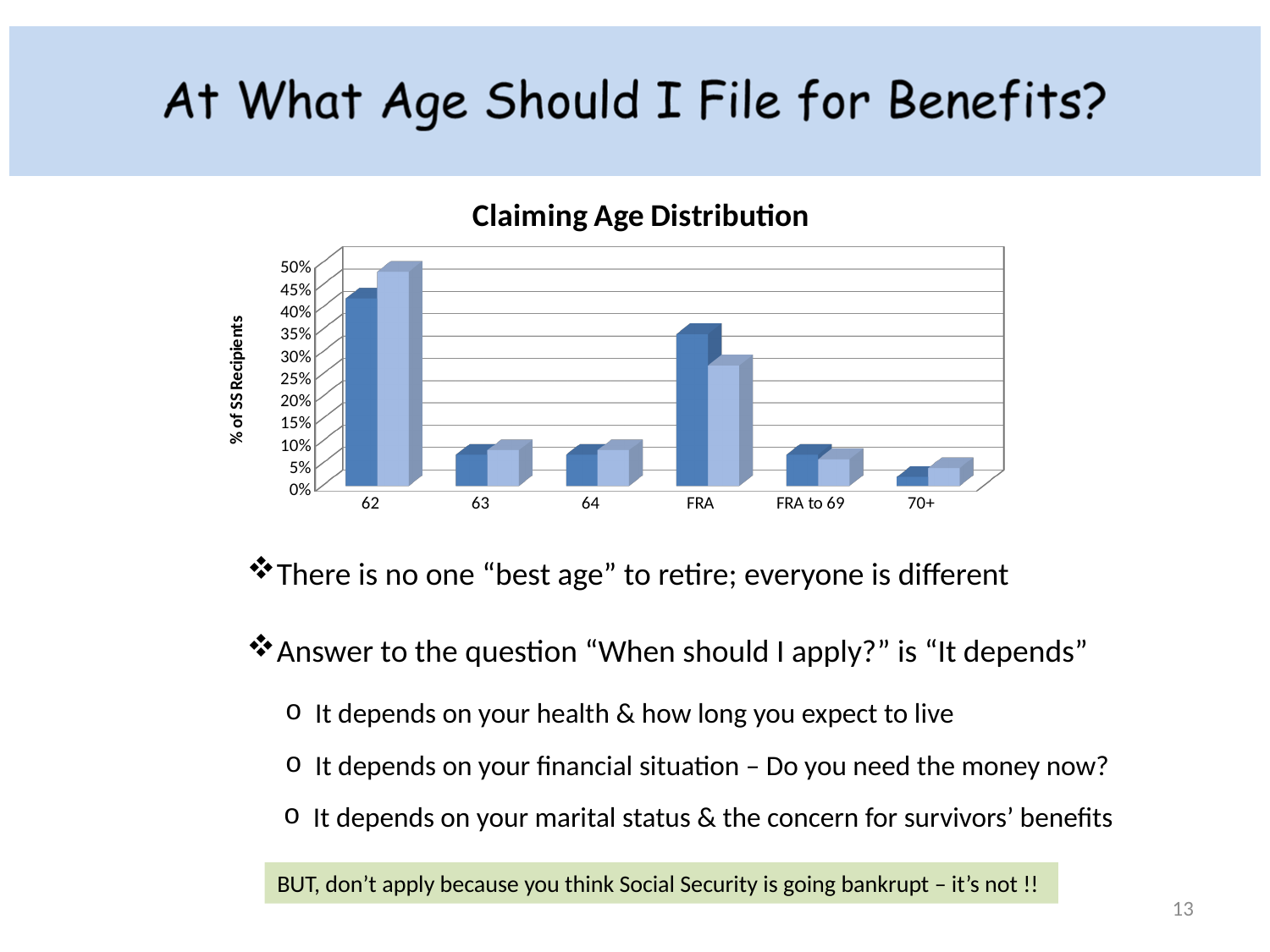
Is the dark blue bar for 70+ greater or less than 5%? less What is the label on the vertical axis of the chart? % of SS Recipients How many bars are plotted for each age category in the chart? 2 For the FRA category, which bar is taller, the dark blue or the light blue one? dark blue Is the dark blue bar for FRA greater or less than 30%? greater Which age category has the highest values in the chart? 62 What is the title of the chart? Claiming Age Distribution What type of chart is shown on the slide? bar chart Which age category has the lowest values in the chart? 70+ How many age categories are shown on the x axis of the chart? 6 Is the dark blue bar for age 63 greater or less than 10%? less